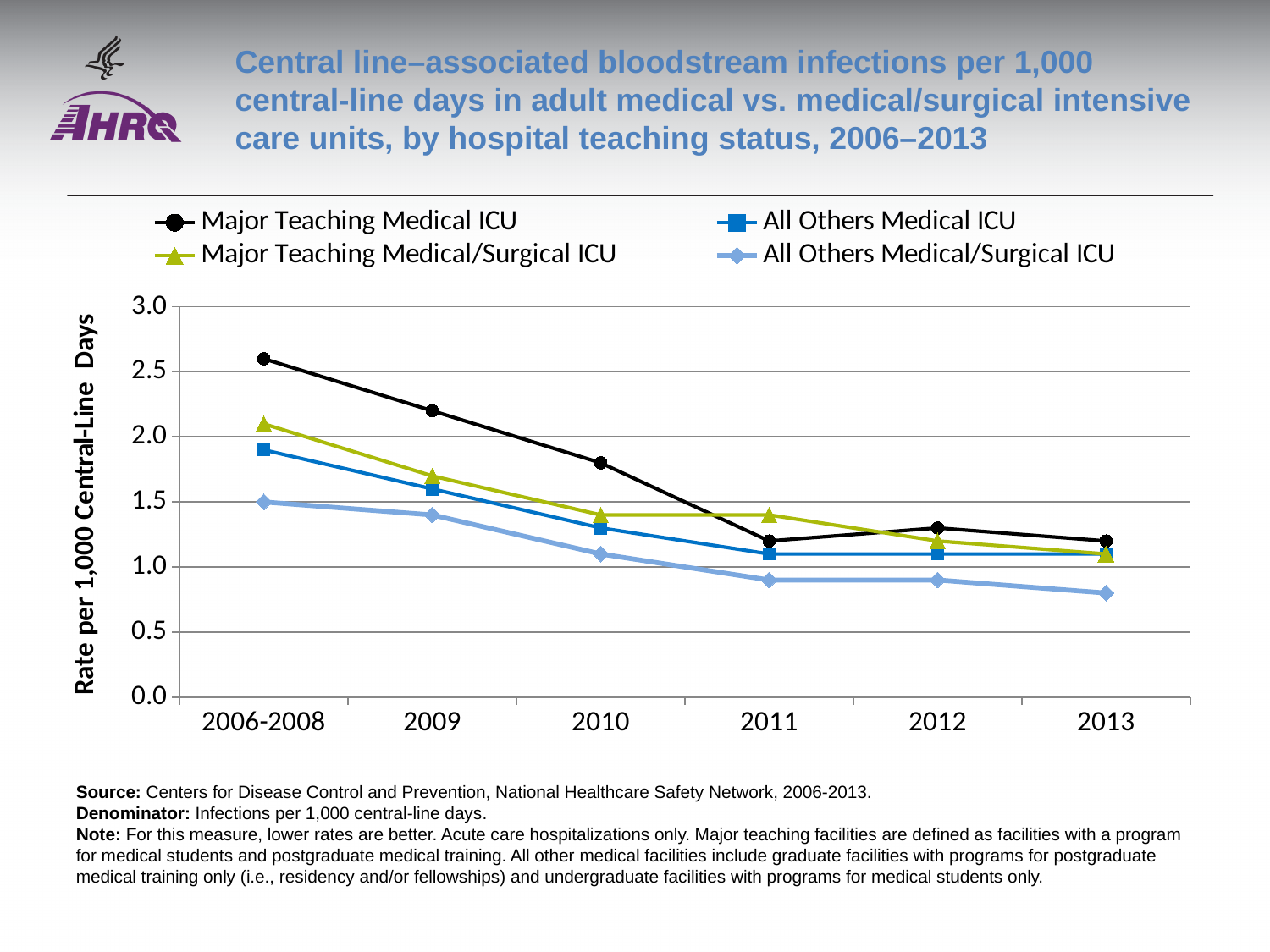
Does the rate for Major Teaching Medical ICU rise or fall from 2006-2008 to 2013? Fall Which series has the lowest rate in 2013? All Others Medical/Surgical ICU Which series has the highest rate in 2006-2008? Major Teaching Medical ICU Is the value for Major Teaching Medical ICU in 2010 greater or less than 1.5? greater Is the value for Major Teaching Medical ICU in 2006-2008 greater or less than 2.5? greater What is the label on the y axis? Rate per 1,000 Central-Line Days How many series does the legend list? 4 In 2006-2008, which is larger: the rate for Major Teaching Medical ICU or for All Others Medical/Surgical ICU? Major Teaching Medical ICU Is the value for All Others Medical ICU in 2009 greater or less than 2.0? less What kind of chart is shown on the slide? Line chart How many time periods are shown on the x axis? 6